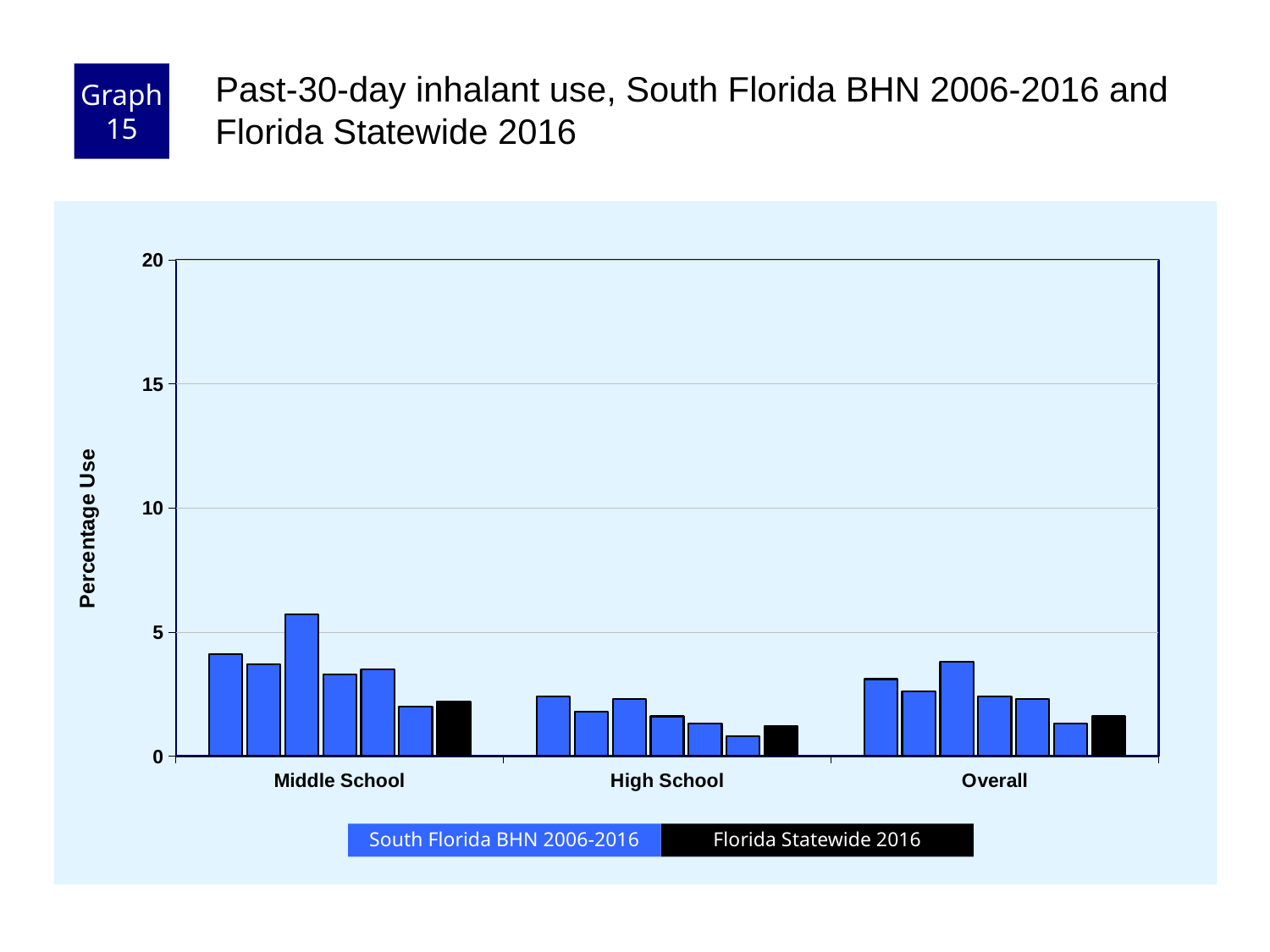
Which category group contains the shortest bar on the chart? High School How many categories are shown along the x axis? 3 Which is larger, the Florida Statewide 2016 bar for Middle School or the Florida Statewide 2016 bar for High School? Middle School How many series does the legend list? 2 What is the label on the y axis? Percentage Use Is the tallest South Florida BHN 2006-2016 bar in the Middle School group greater or less than 5? greater Is the Florida Statewide 2016 value for High School greater or less than 5? less Which category group contains the tallest bar on the chart? Middle School Do the South Florida BHN 2006-2016 bars in the High School group generally rise or fall from left to right? fall What kind of chart is shown on the slide? bar chart Is the Florida Statewide 2016 value for Middle School greater or less than 5? less How many bars are plotted in the Middle School group? 7